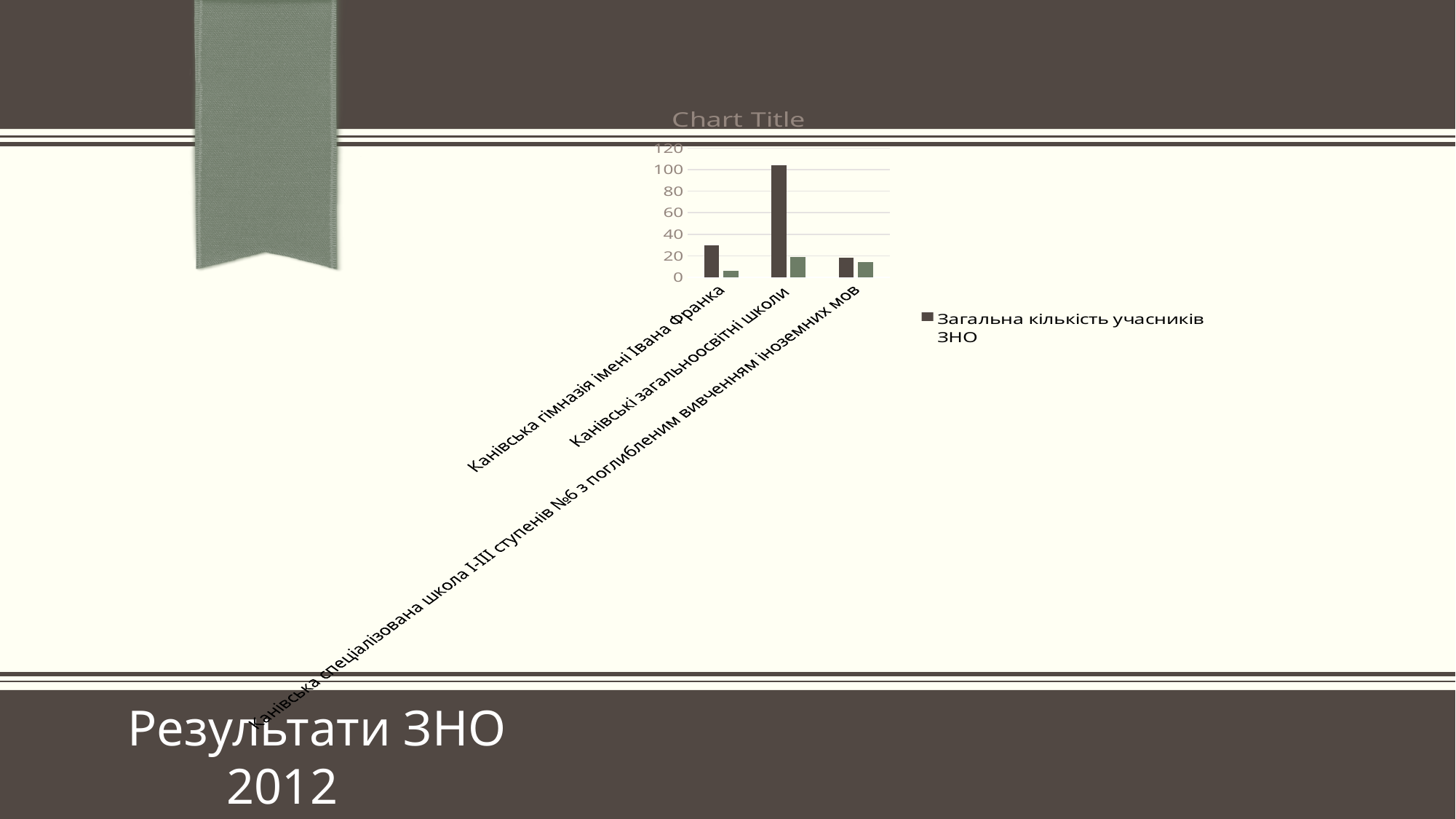
Is the value for Загальна кількість учасників ЗНО for Канівська гімназія імені Івана Франка greater or less than 20? greater Which category has the lowest green bar in the chart? Канівська гімназія імені Івана Франка What legend entry is shown for the dark bars in the chart? Загальна кількість учасників ЗНО Is the value for Загальна кількість учасників ЗНО for Канівські загальноосвітні школи greater or less than 80? greater Is the value for Загальна кількість учасників ЗНО for Канівська гімназія імені Івана Франка greater or less than 40? less What is the title of the chart? Chart Title What kind of chart is shown on the slide? bar chart Which category has the highest value for Загальна кількість учасників ЗНО? Канівські загальноосвітні школи How many categories are shown on the x axis of the chart? 3 Which category has the lowest value for Загальна кількість учасників ЗНО? Канівська спеціалізована школа I-III ступенів №6 з поглибленим вивченням іноземних мов Which is larger for Загальна кількість учасників ЗНО: Канівська гімназія імені Івана Франка or Канівська спеціалізована школа I-III ступенів №6 з поглибленим вивченням іноземних мов? Канівська гімназія імені Івана Франка